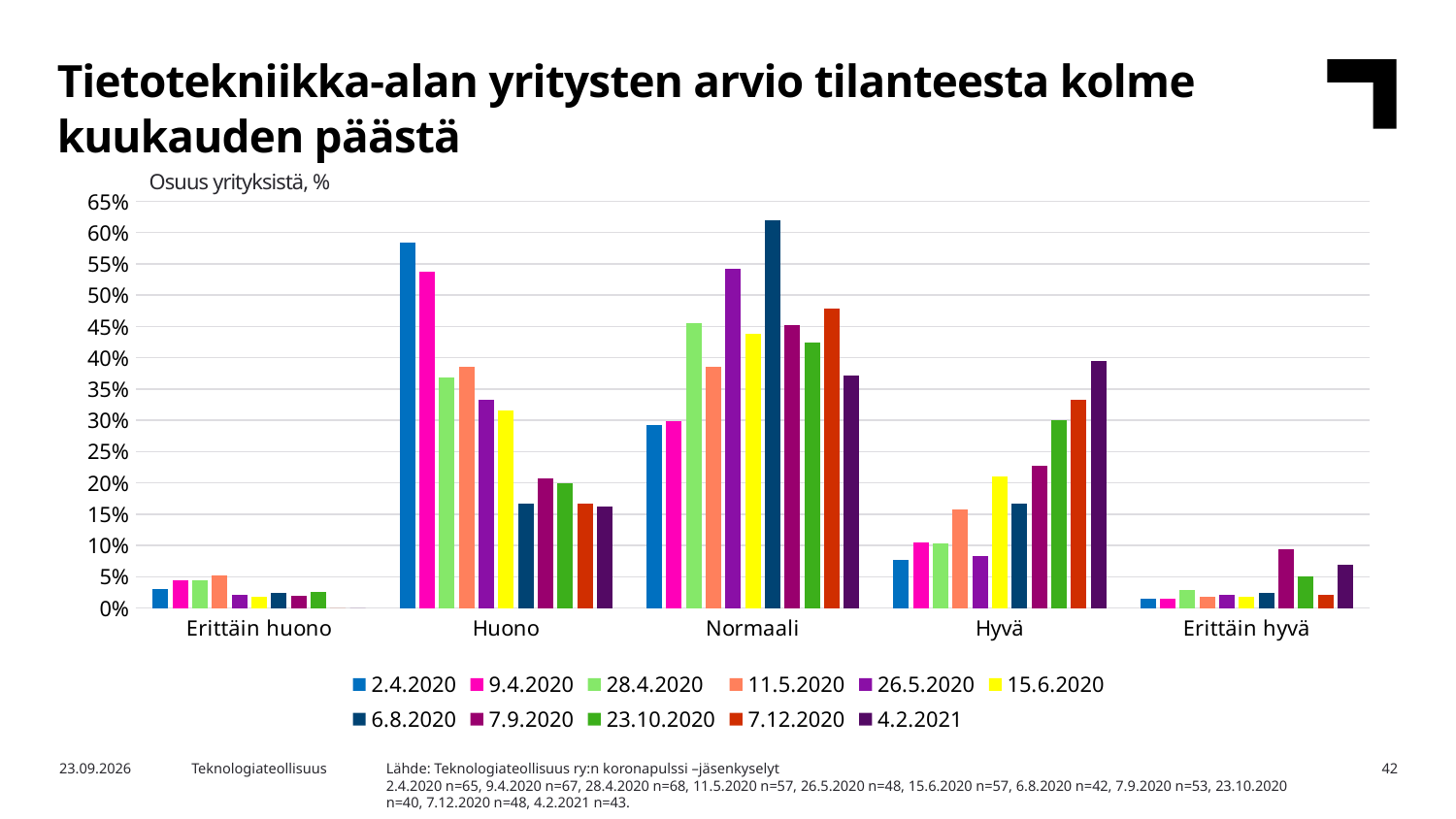
Is the value for 2.4.2020 in the Normaali category greater or less than 35%? less Which series has the highest value in the Normaali category? 6.8.2020 How many series does the legend list? 11 Which series has the highest value in the Erittäin hyvä category? 7.9.2020 Which series has the highest value in the Hyvä category? 4.2.2021 What is the label shown above the vertical axis? Osuus yrityksistä, % In the Hyvä category, which is larger: the value for 4.2.2021 or the value for 7.12.2020? 4.2.2021 How many categories are shown on the x axis? 5 Is the value for 4.2.2021 in the Hyvä category greater or less than 35%? greater Is the value for 2.4.2020 in the Huono category greater or less than 55%? greater What kind of chart is shown on the slide? bar chart